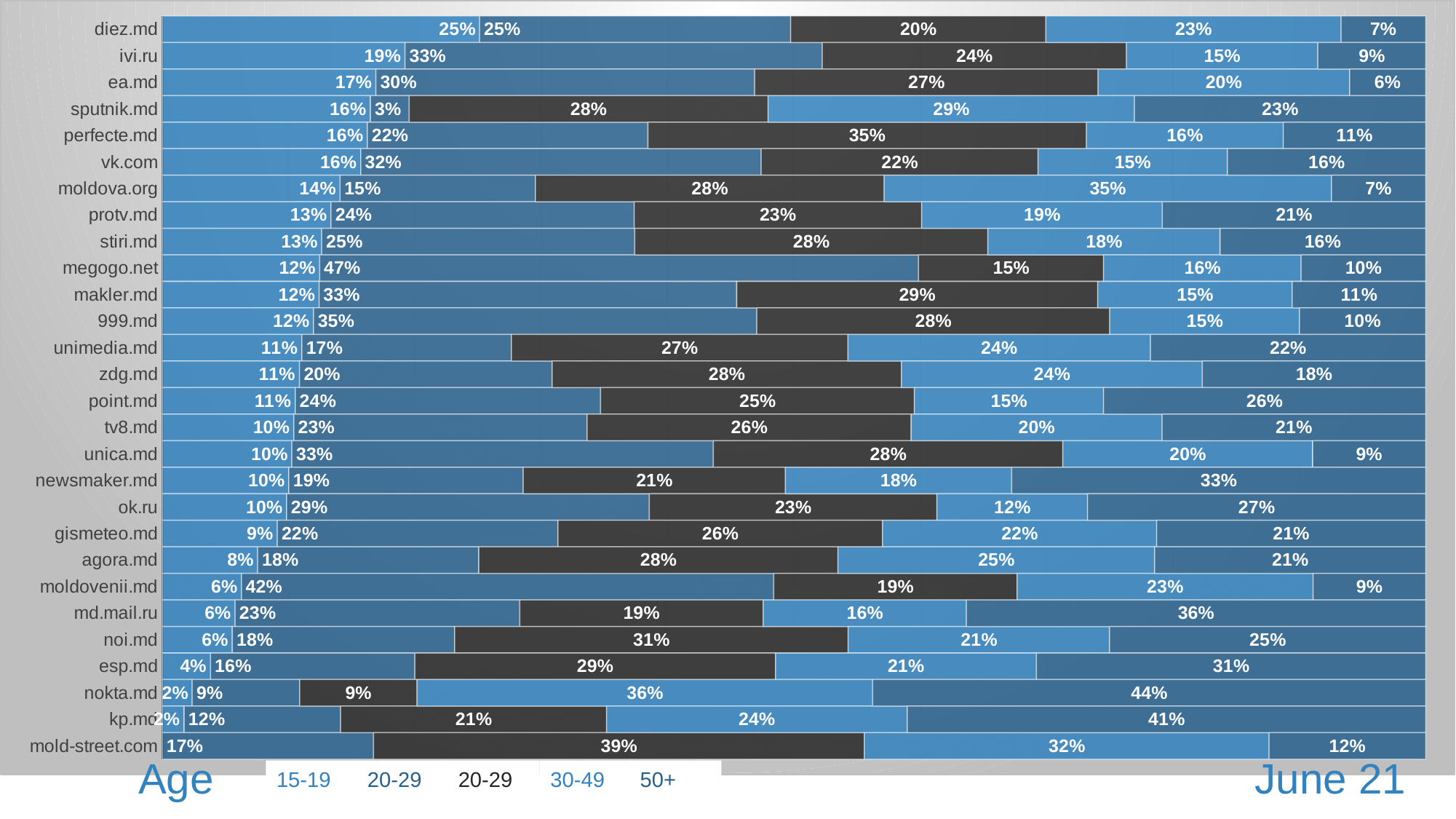
How many series does the legend list? 5 What type of chart is shown on the slide? Stacked bar chart What is the 50+ value for md.mail.ru? 36% What is the difference between the 15-19 values of diez.md and ivi.ru? 6 percentage points Which has a larger 50+ value, nokta.md or diez.md? nokta.md What is the total of the stacked bar for diez.md? 100% What is the 30-49 value for moldova.org? 35% What is the 50+ value for nokta.md? 44% How many websites (categories) are listed on the chart? 28 What is the 15-19 value for diez.md? 25% Which website has the highest 15-19 value? diez.md Which website has the highest 50+ value? nokta.md